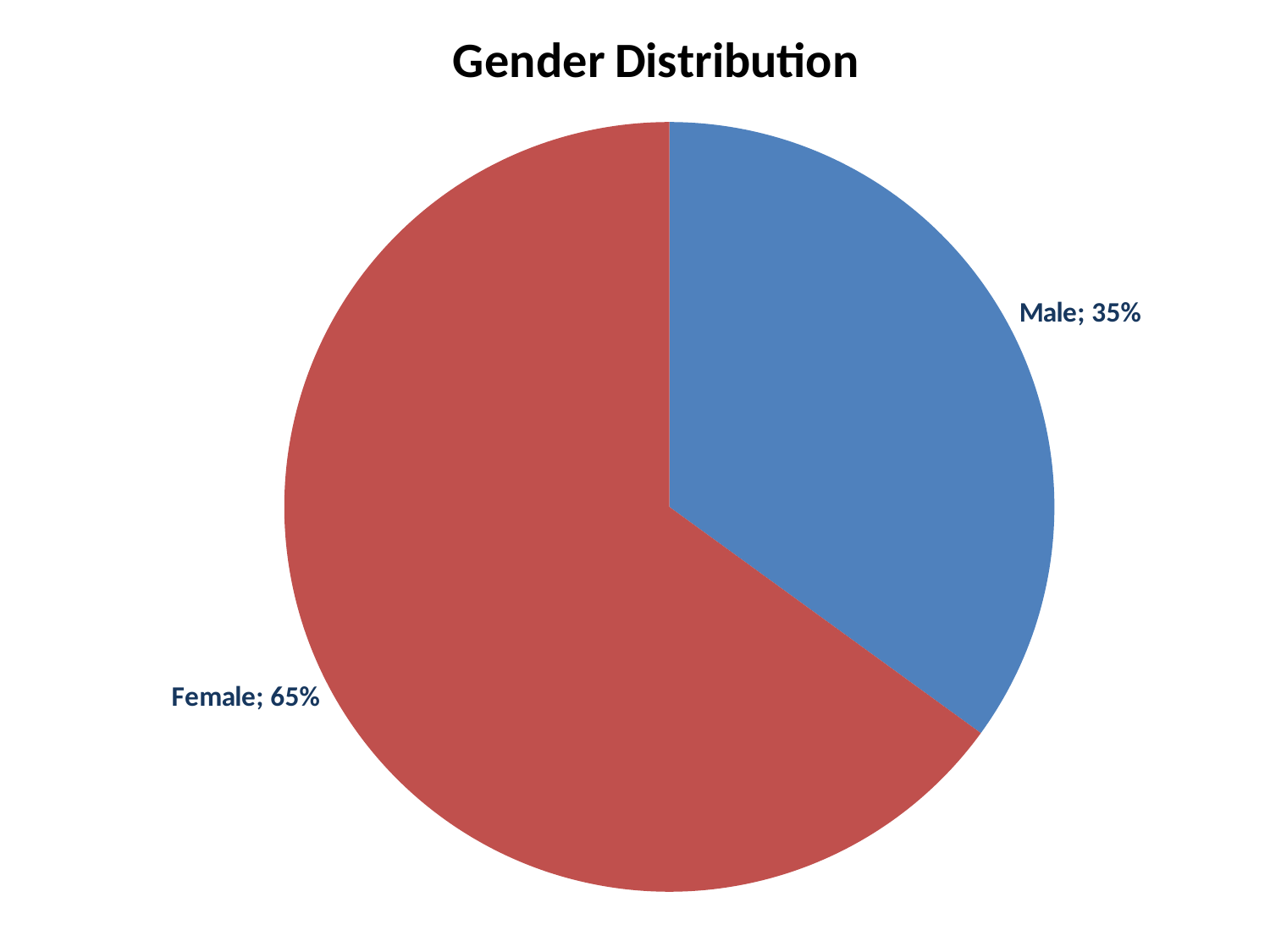
What share of the pie does the Male slice represent? 35% Which category has the smallest share of the pie? Male What is the difference in percentage points between the Female and Male shares? 30 Which is larger, the Female share or the Male share? Female What colour is the Female slice? Red Which category has the largest share of the pie? Female What percentage of the pie is Male? 35% How many slices does the pie chart have? 2 What type of chart is shown on the slide? Pie chart What is the title of the chart? Gender Distribution What percentage of the pie is Female? 65%